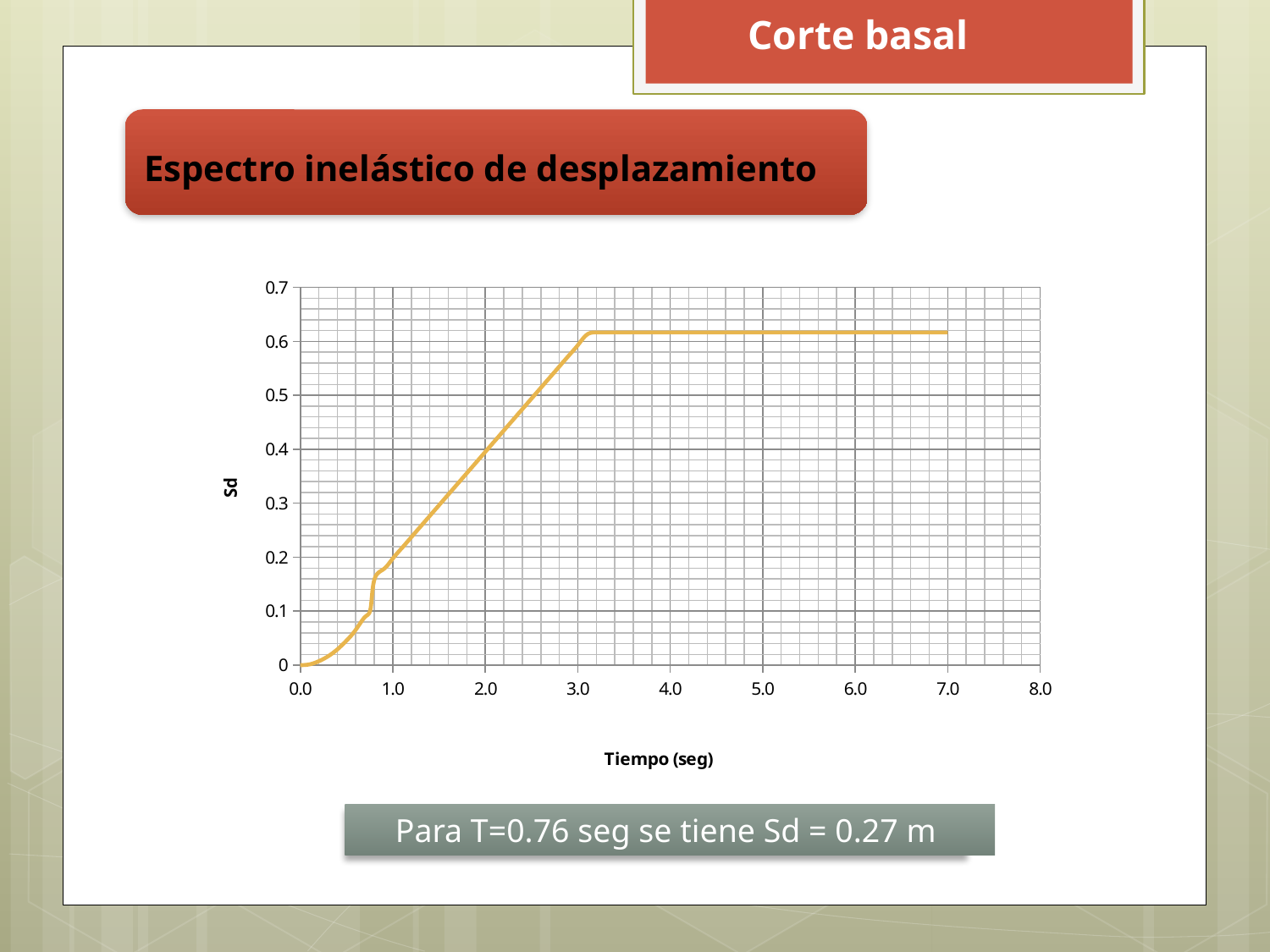
Is the value of Sd at Tiempo 2.0 greater or less than 0.3? greater What is the label of the x axis of the chart? Tiempo (seg) Is the value of Sd at Tiempo 1.0 greater or less than 0.3? less Which has the larger Sd value, Tiempo 1.0 or Tiempo 4.0? Tiempo 4.0 Is the value of Sd at Tiempo 5.0 greater or less than 0.5? greater What is the highest tick value shown on the y axis? 0.7 What kind of chart is shown on the slide? line chart What is the label of the y axis of the chart? Sd Does the plotted line rise or fall between Tiempo 0.0 and 3.0? rise What is the value of Sd at Tiempo 0.0? 0